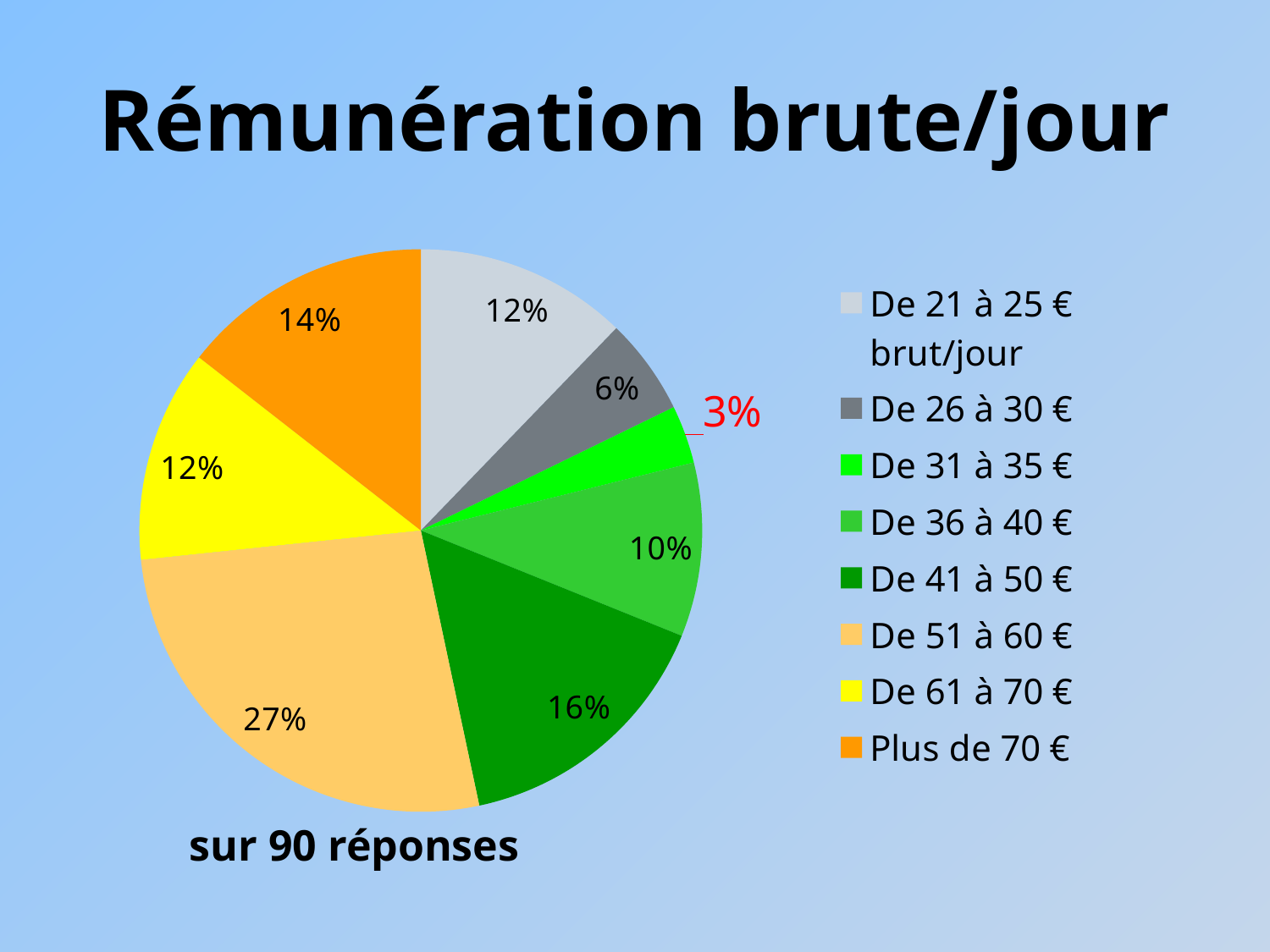
Which category has the largest slice? De 51 à 60 € What is the value for 'De 41 à 50 €'? 16% What kind of chart is shown on the slide? Pie chart How many responses does the chart say it is based on? 90 réponses Which is larger, 'De 36 à 40 €' or 'De 26 à 30 €'? De 36 à 40 € Which category has the smallest slice? De 31 à 35 € What is the value for 'Plus de 70 €'? 14% What is the value for 'De 31 à 35 €'? 3% What share of the pie is 'De 51 à 60 €'? 27% How many categories does the legend list? 8 What is the title of the chart? Rémunération brute/jour What is the difference between the 'De 51 à 60 €' slice and the 'De 41 à 50 €' slice? 11%